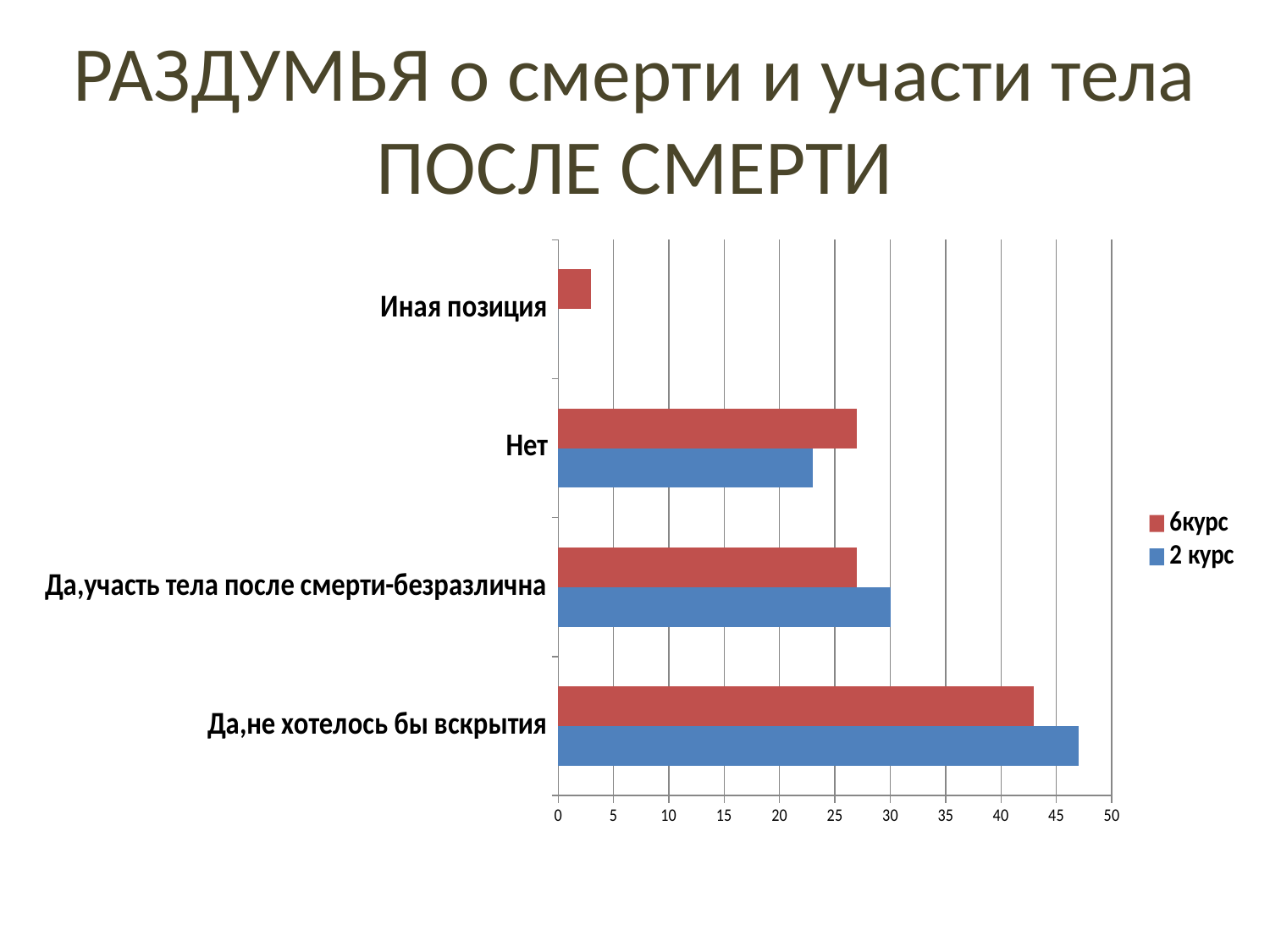
Is the 6курс value for Да,не хотелось бы вскрытия greater or less than 40? greater Is the 2 курс value for Нет greater or less than 25? less How many series does the legend list? 2 Which category has the lowest value for the 6курс series? Иная позиция How many categories are shown on the vertical axis of the chart? 4 Which category has the highest value for the 6курс series? Да,не хотелось бы вскрытия For the category Нет, which series has the larger value, 6курс or 2 курс? 6курс For the category Да,не хотелось бы вскрытия, which series has the larger value, 6курс or 2 курс? 2 курс What kind of chart is shown on the slide? bar chart What colour represents the 6курс series in the chart? red Which category has the highest value for the 2 курс series? Да,не хотелось бы вскрытия Is the 6курс value for Иная позиция greater or less than 5? less